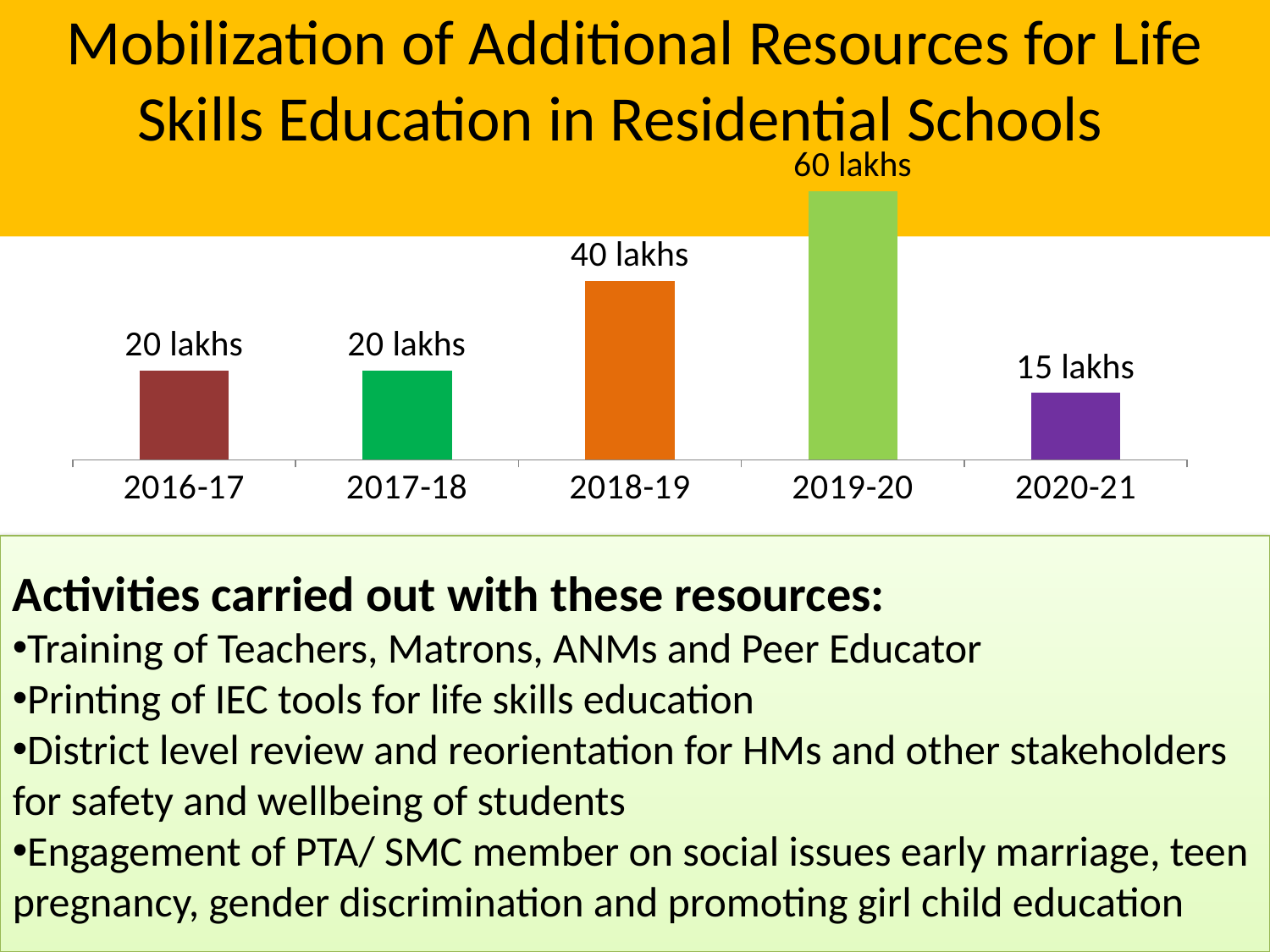
Which year has the lowest value? 2020-21 Which year has the highest value? 2019-20 Do the values rise or fall from 2019-20 to 2020-21? fall What value is shown for 2016-17? 20 lakhs What colour is the bar for 2019-20? light green What value is shown for 2018-19? 40 lakhs What is the difference between the values for 2017-18 and 2020-21? 5 lakhs What is the difference between the values for 2019-20 and 2018-19? 20 lakhs What value is shown for 2020-21? 15 lakhs How many years are shown on the x axis? 5 What kind of chart is shown on the slide? bar chart Which is larger, the value for 2018-19 or the value for 2020-21? 2018-19